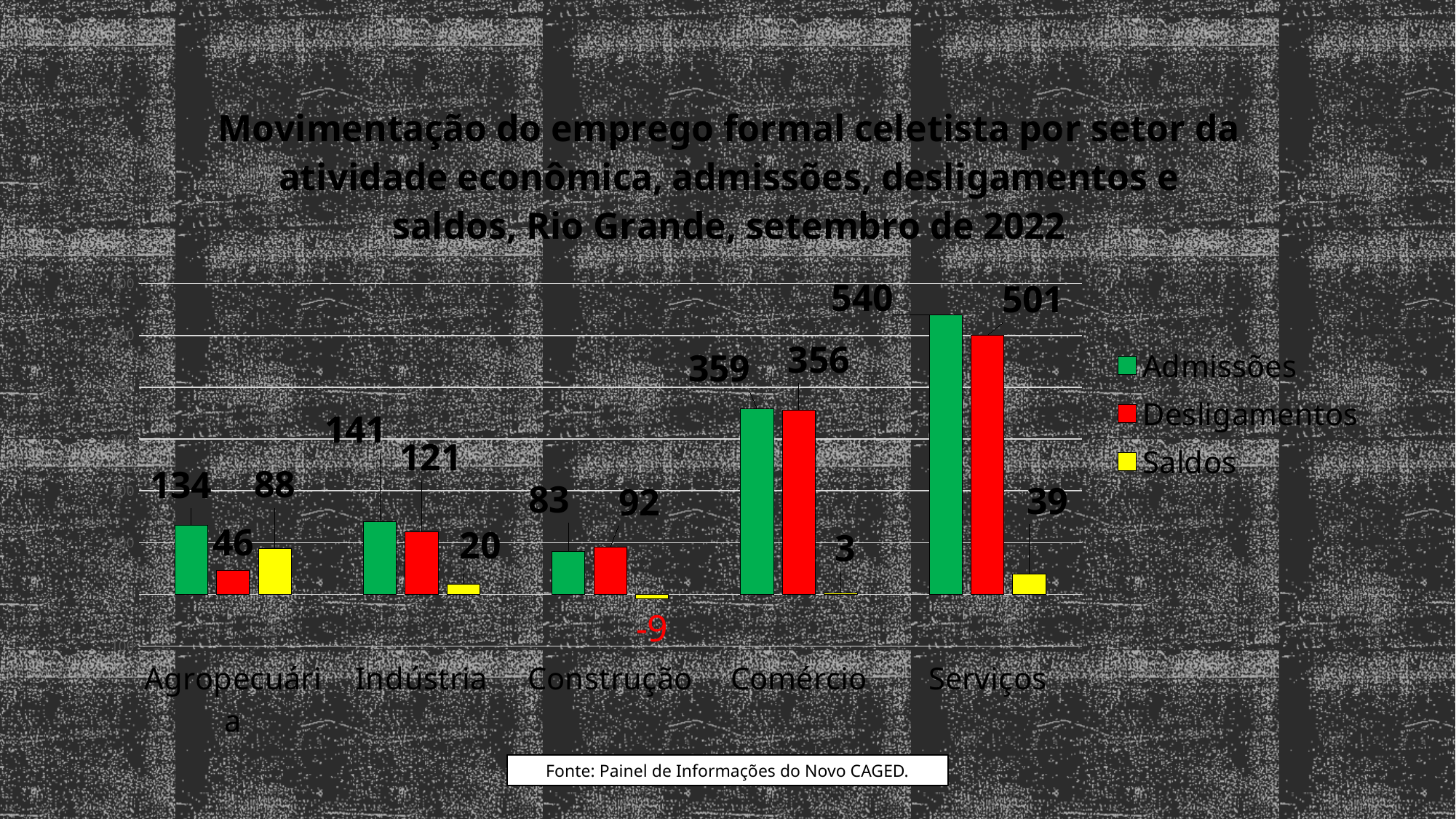
Which colour represents the Saldos series? Yellow What is the value of Saldos for Agropecuária? 88 Which sector has the lowest value for Saldos? Construção What is the value of Desligamentos for Indústria? 121 What is the value of Admissões for Serviços? 540 How many series does the legend list? 3 What is the difference between Admissões and Desligamentos for Serviços? 39 What is the value of Saldos for Construção? -9 Which sector has the highest value for Admissões? Serviços How many sectors are shown on the x axis? 5 Which is larger for Construção, Admissões or Desligamentos? Desligamentos What kind of chart is shown on the slide? Bar chart